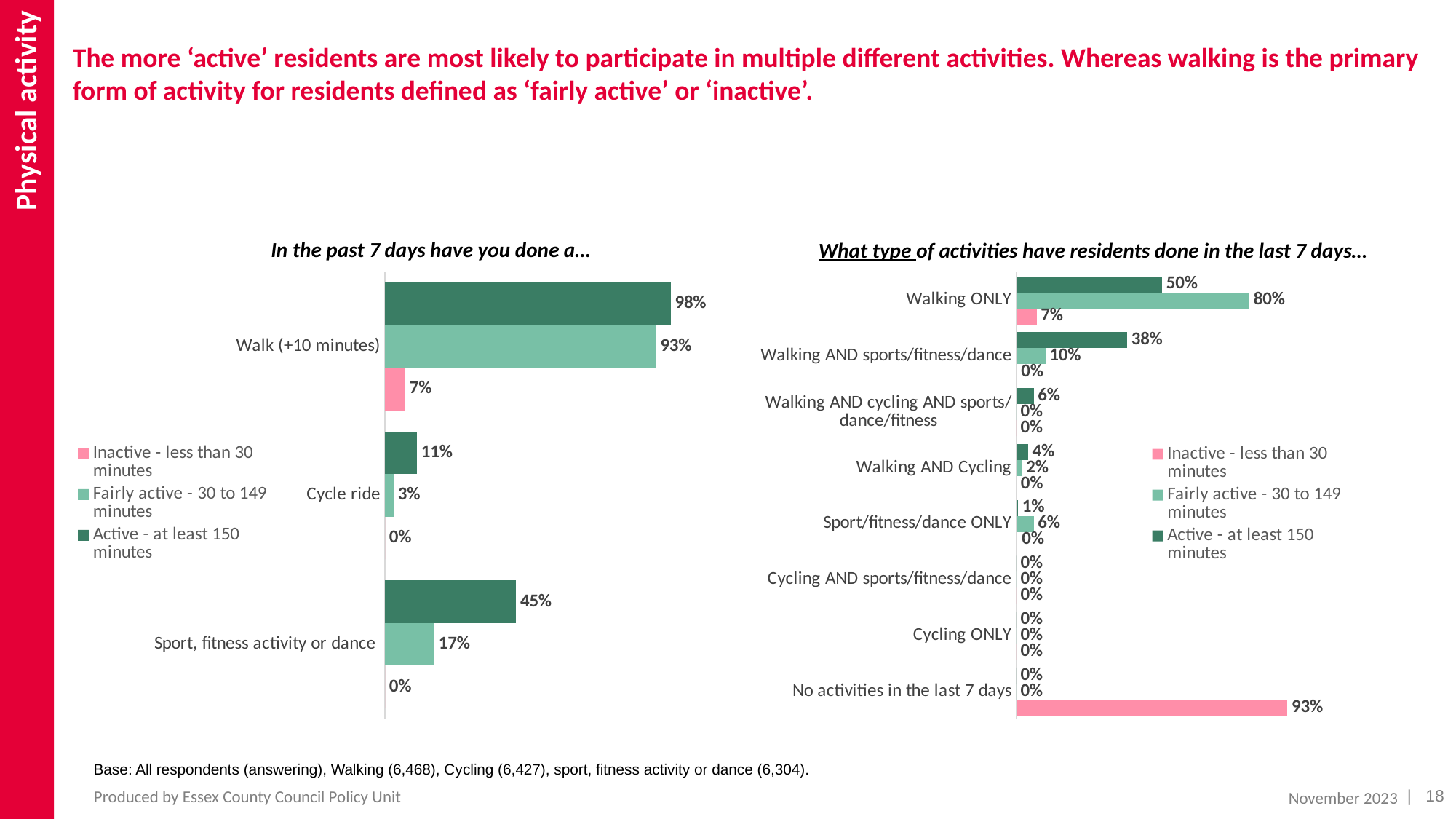
What kind of chart is 'What type of activities have residents done in the last 7 days...'? Bar chart In the chart 'In the past 7 days have you done a...', what percentage of 'Fairly active - 30 to 149 minutes' residents did Sport, fitness activity or dance? 17% In the chart 'What type of activities have residents done in the last 7 days...', what is the difference between the Active and Fairly active values for Walking AND sports/fitness/dance? 28% In the chart 'In the past 7 days have you done a...', how many series does the legend list? 3 In the chart 'What type of activities have residents done in the last 7 days...', what percentage of 'Inactive - less than 30 minutes' residents had No activities in the last 7 days? 93% In the chart 'In the past 7 days have you done a...', how many activity categories are shown? 3 In the chart 'What type of activities have residents done in the last 7 days...', which category has the highest value for 'Active - at least 150 minutes' residents? Walking ONLY In the chart 'What type of activities have residents done in the last 7 days...', what percentage of 'Fairly active - 30 to 149 minutes' residents did Walking ONLY? 80% In the chart 'What type of activities have residents done in the last 7 days...', how many activity categories are listed? 8 In the chart 'In the past 7 days have you done a...', what is the difference between the Active and Fairly active values for Cycle ride? 8% In the chart 'What type of activities have residents done in the last 7 days...', which is larger for Sport/fitness/dance ONLY: the Active value or the Fairly active value? Fairly active In the chart 'In the past 7 days have you done a...', what percentage of 'Active - at least 150 minutes' residents did a Walk (+10 minutes)? 98%